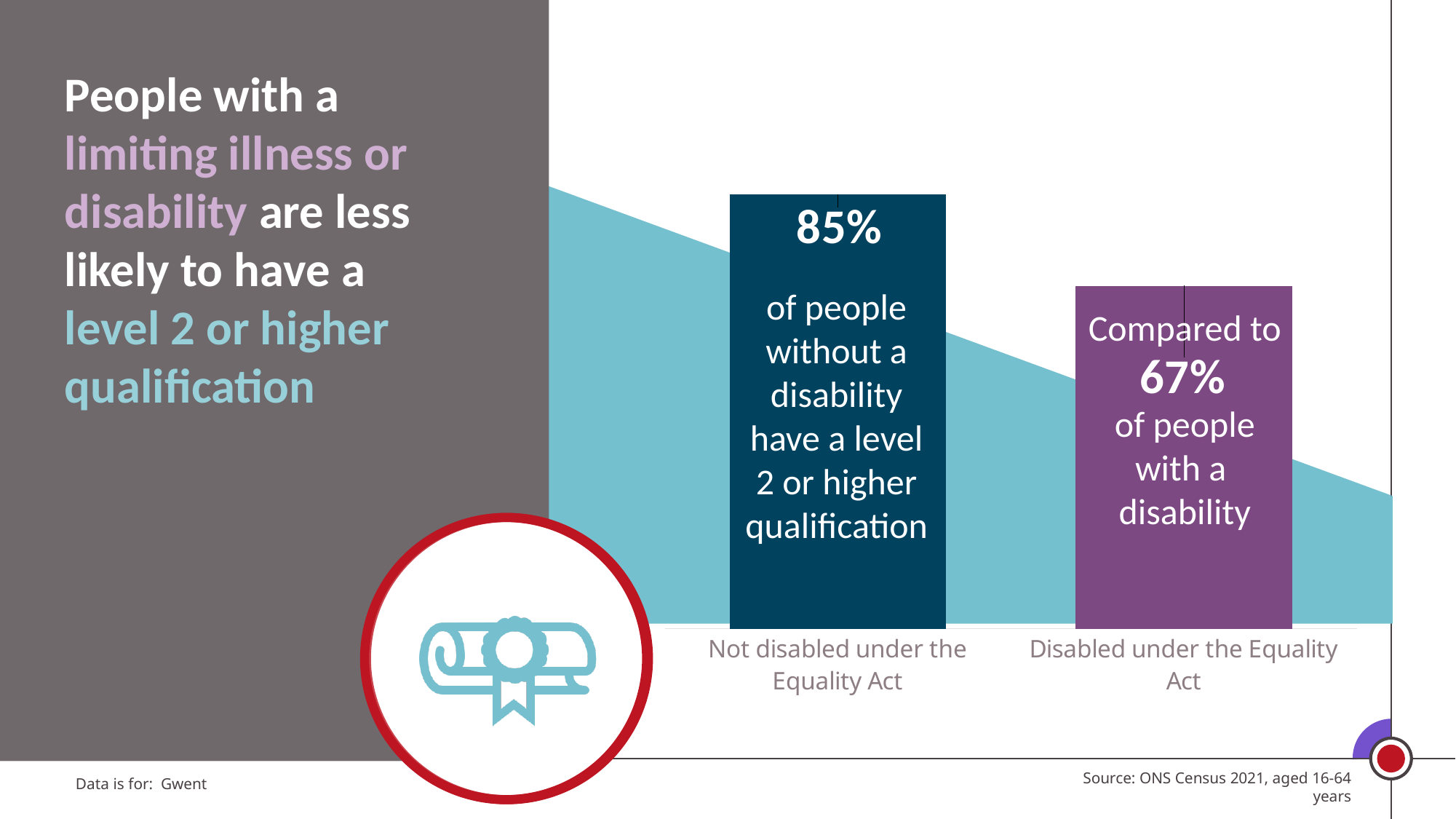
What colour is the bar for people disabled under the Equality Act? purple Is the value for people not disabled under the Equality Act larger or smaller than the value for people disabled under the Equality Act? larger What percentage of people not disabled under the Equality Act have a level 2 or higher qualification? 85% What kind of chart is shown on the slide? bar chart Which area does the data on the slide cover? Gwent What is the difference in percentage points between the two bars? 18 How many categories are shown in the chart? 2 Which category has the higher value? Not disabled under the Equality Act Which category has the lower value? Disabled under the Equality Act What percentage of people disabled under the Equality Act have a level 2 or higher qualification? 67%